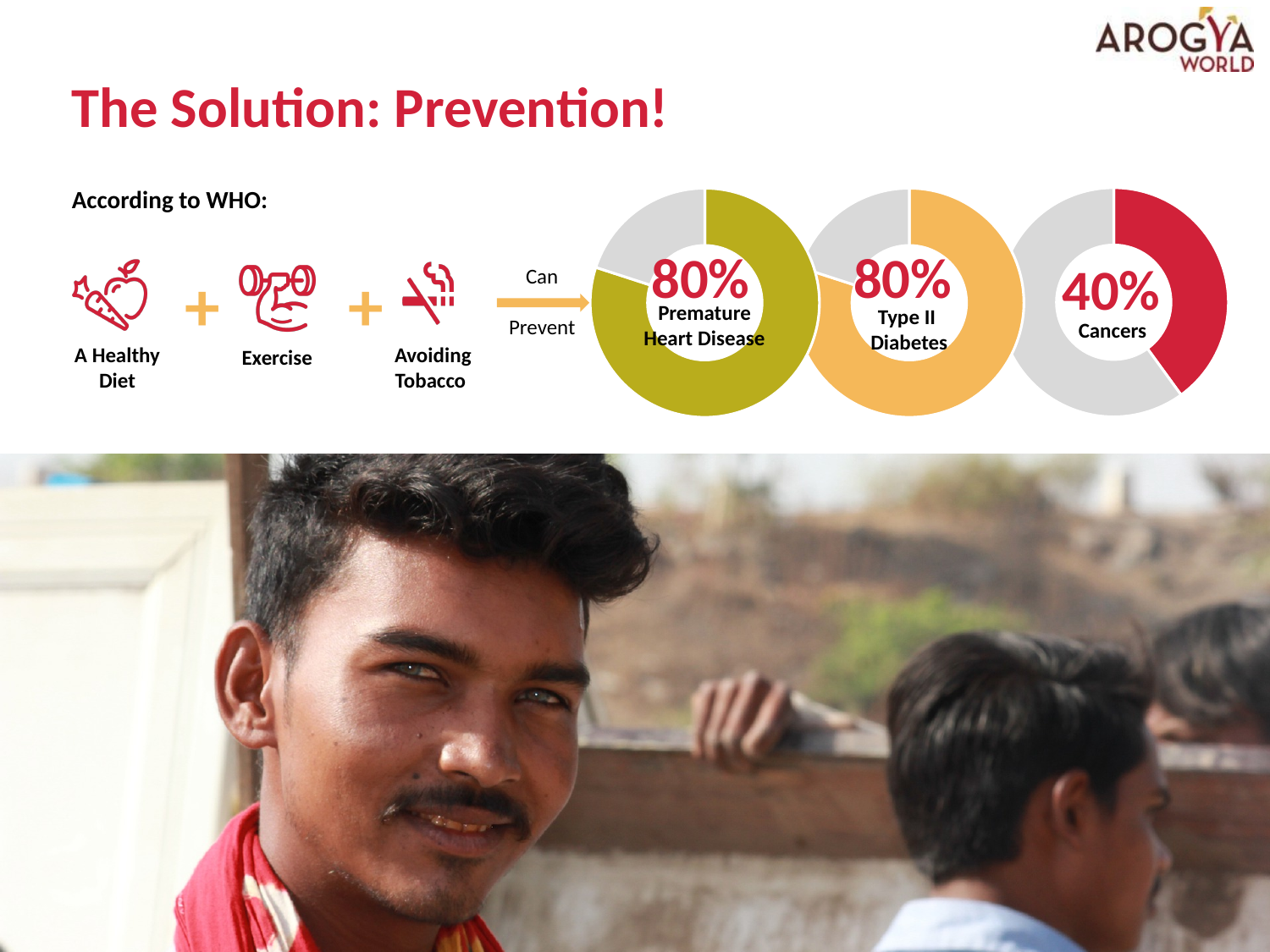
Do the Premature Heart Disease and Type II Diabetes donut charts show the same percentage? Yes Is the percentage shown for Cancers greater or less than 50%? less Which is larger, the percentage for Type II Diabetes or the percentage for Cancers? Type II Diabetes What percentage is shown in the Cancers donut chart? 40% What percentage is shown in the Type II Diabetes donut chart? 80% What kind of chart is used to show the Cancers percentage? Donut chart How many donut charts are shown on the slide? 3 What percentage is shown in the Premature Heart Disease donut chart? 80% What colour is the filled portion of the Cancers donut chart? Red Which of the three donut charts shows the lowest percentage? Cancers What is the difference between the percentage shown for Premature Heart Disease and the percentage shown for Cancers? 40% What colour is the filled portion of the Type II Diabetes donut chart? Orange